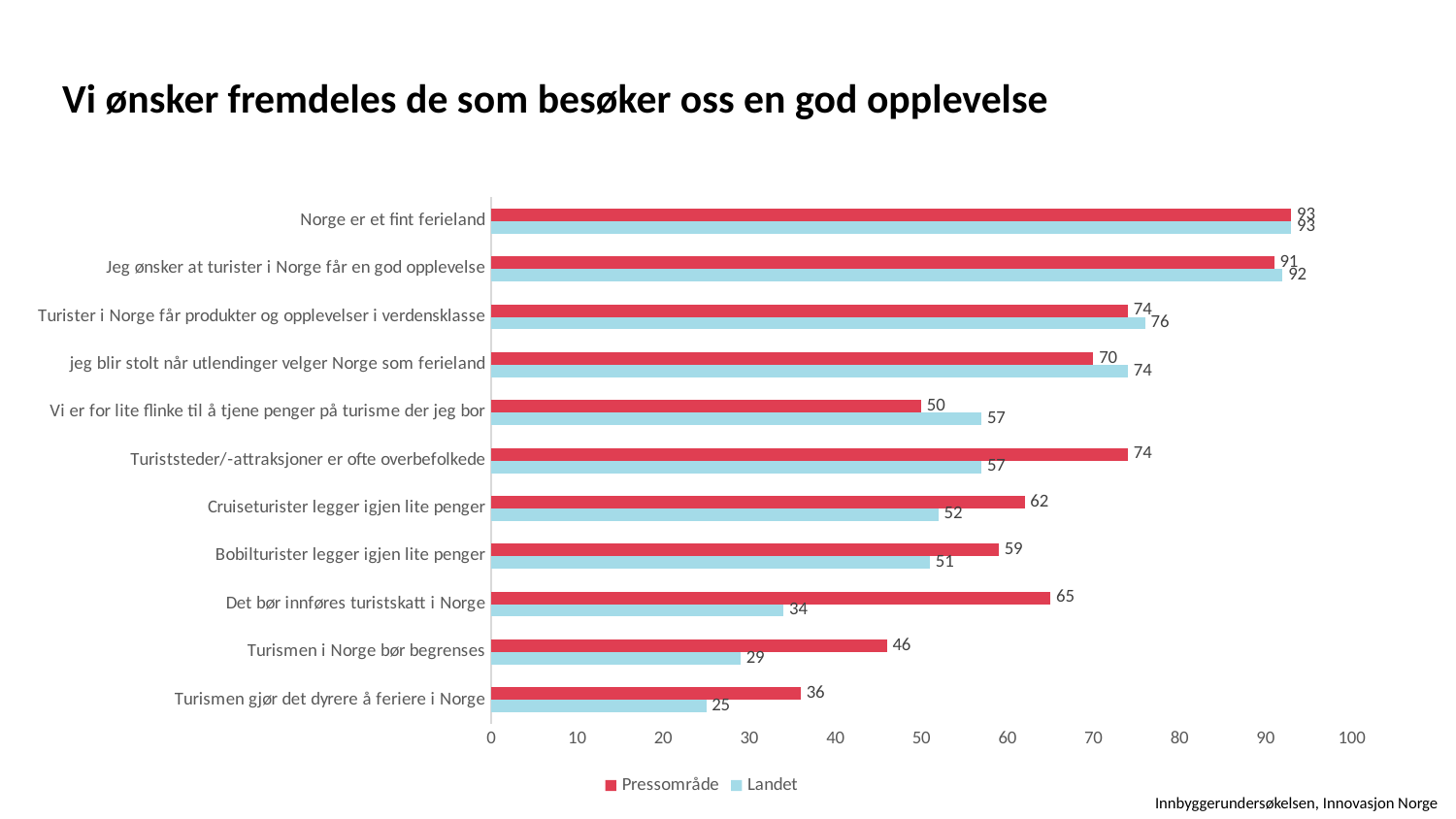
How many series does the legend list? 2 Which category has the lowest Landet value? Turismen gjør det dyrere å feriere i Norge How many categories are shown in the chart? 11 For "Turiststeder/-attraksjoner er ofte overbefolkede", which series has the larger value, Pressområde or Landet? Pressområde What is the Pressområde value for "Det bør innføres turistskatt i Norge"? 65 What is the difference between the Pressområde and Landet values for "Det bør innføres turistskatt i Norge"? 31 Is the Landet value for "Cruiseturister legger igjen lite penger" greater or less than 60? less Which category has the highest Pressområde value? Norge er et fint ferieland What is the Landet value for "Vi er for lite flinke til å tjene penger på turisme der jeg bor"? 57 What is the title of the slide? Vi ønsker fremdeles de som besøker oss en god opplevelse What type of chart is shown on the slide? Bar chart What is the Landet value for "Turismen i Norge bør begrenses"? 29